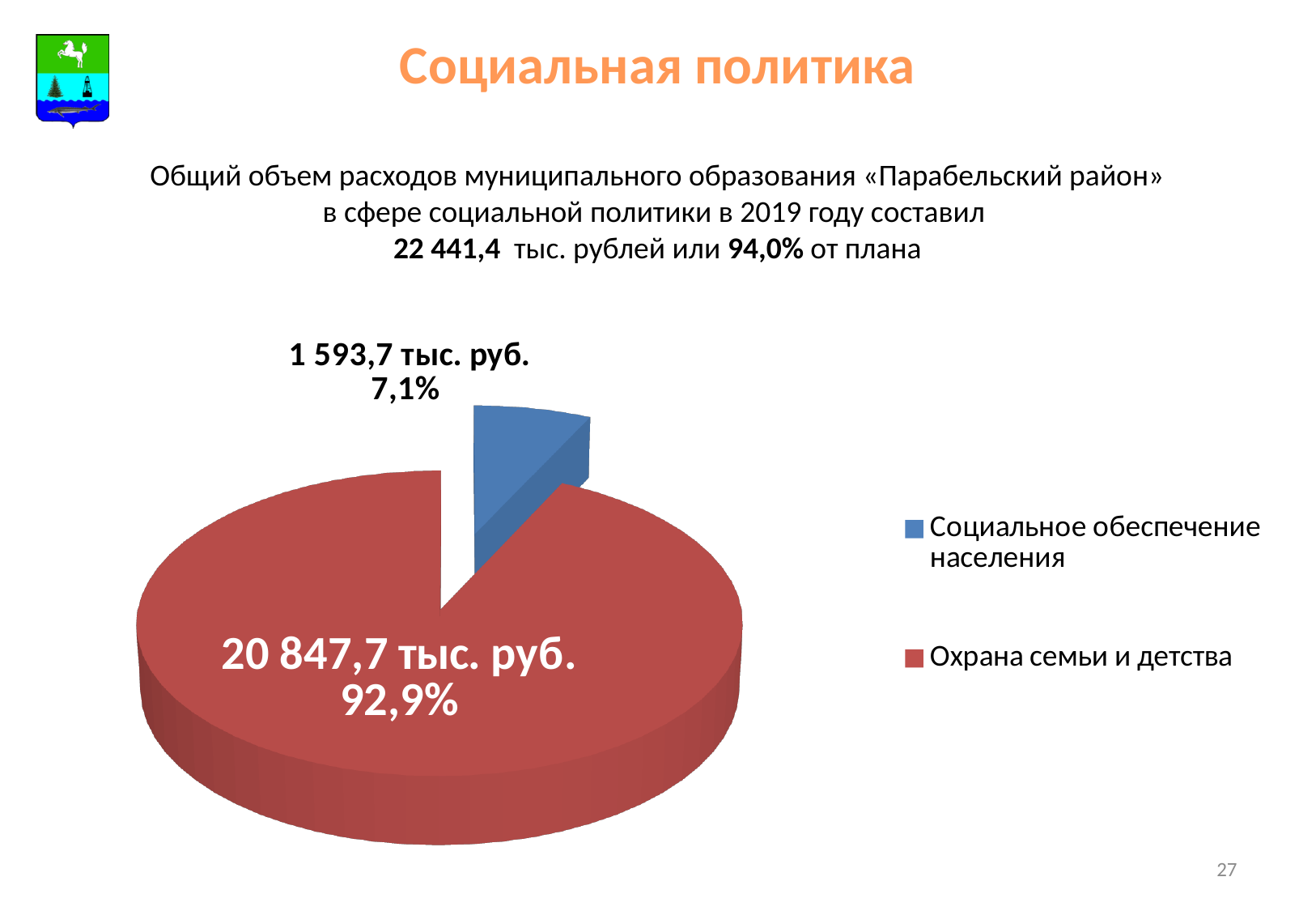
What share of the pie does «Социальное обеспечение населения» take? 7,1% What colour is the slice for «Социальное обеспечение населения»? blue What kind of chart is shown on the slide? pie chart What is the value for «Социальное обеспечение населения» in the pie chart? 1 593,7 тыс. руб. How many entries does the legend of the pie chart list? 2 How many slices does the pie chart have? 2 Which is larger: «Охрана семьи и детства» or «Социальное обеспечение населения»? Охрана семьи и детства What is the difference in тыс. руб. between «Охрана семьи и детства» and «Социальное обеспечение населения»? 19 254,0 тыс. руб. Which category has the smallest slice in the pie chart? Социальное обеспечение населения What share of the pie does «Охрана семьи и детства» take? 92,9% Which category has the largest slice in the pie chart? Охрана семьи и детства What is the value for «Охрана семьи и детства» in the pie chart? 20 847,7 тыс. руб.